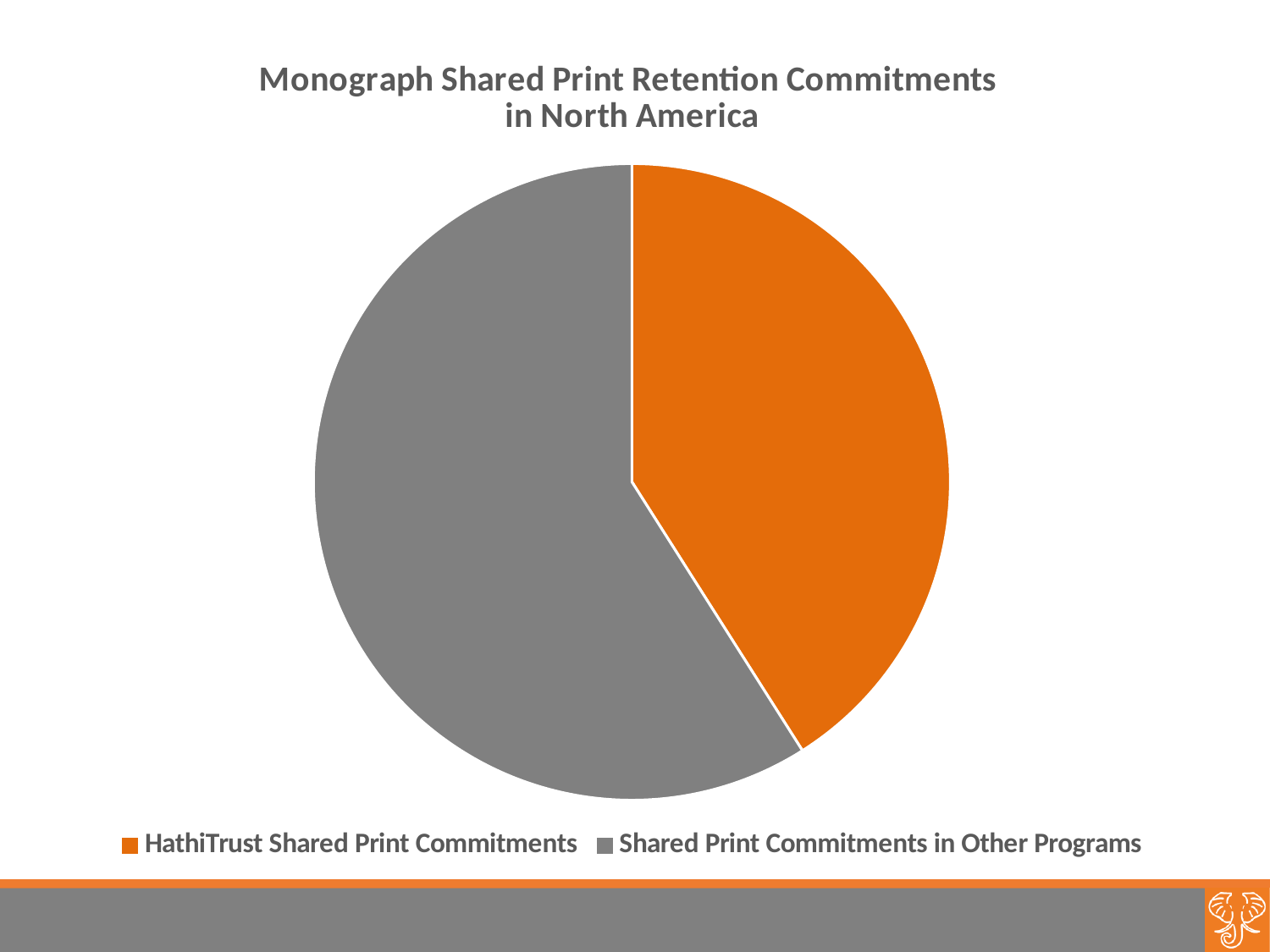
What is the title of the chart? Monograph Shared Print Retention Commitments in North America How many entries does the legend list? 2 Which category has the largest slice of the pie? Shared Print Commitments in Other Programs Does the slice for HathiTrust Shared Print Commitments cover more or less than half of the pie? less What colour represents HathiTrust Shared Print Commitments in the pie chart? orange Which is larger: the slice for HathiTrust Shared Print Commitments or the slice for Shared Print Commitments in Other Programs? Shared Print Commitments in Other Programs Which category has the smallest slice of the pie? HathiTrust Shared Print Commitments Does the slice for Shared Print Commitments in Other Programs cover more or less than half of the pie? more How many slices does the pie chart have? 2 What kind of chart is shown on the slide? pie chart